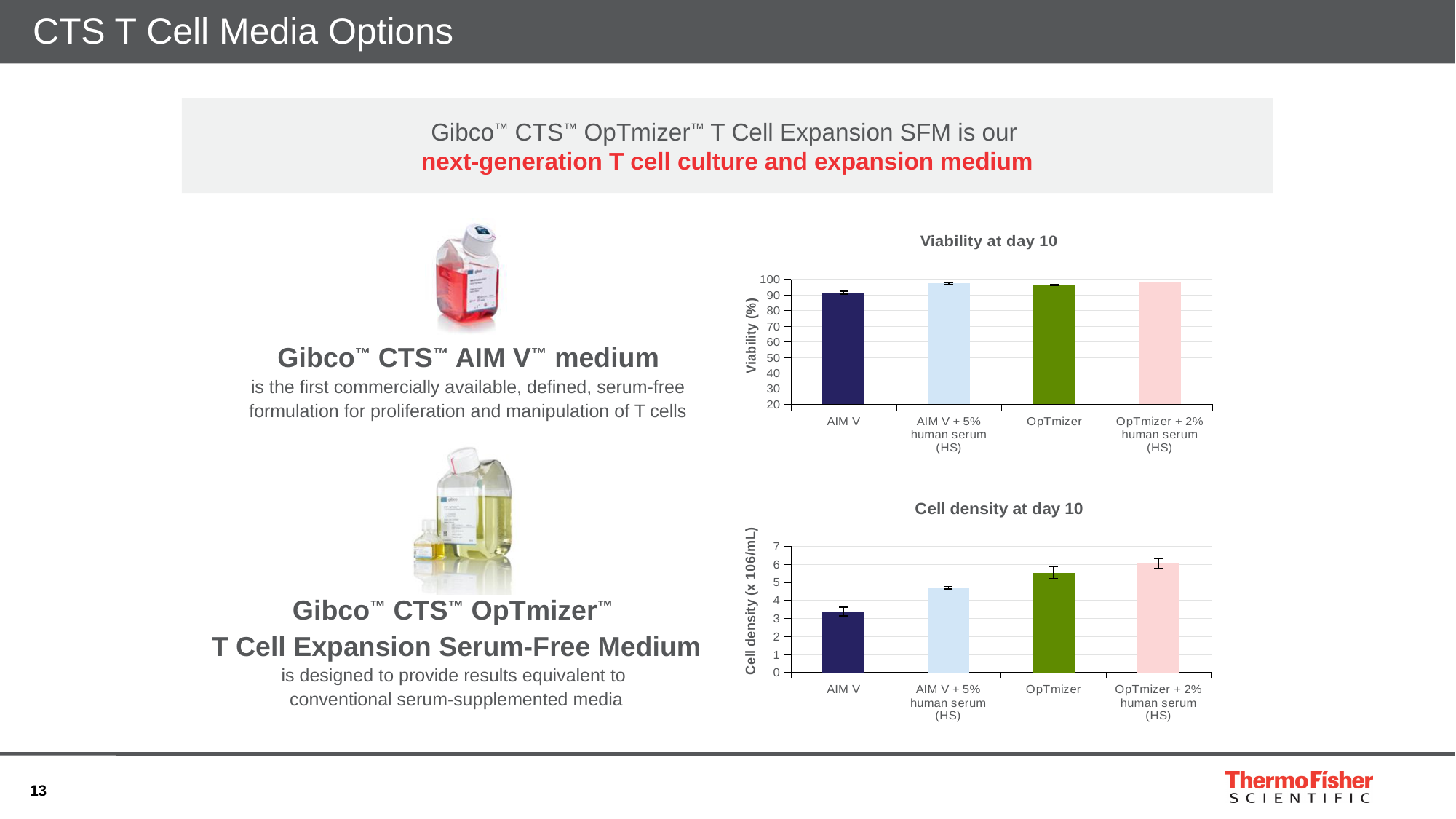
In the "Cell density at day 10" chart, which category has the highest cell density? OpTmizer + 2% human serum (HS) In the "Cell density at day 10" chart, is the value for AIM V greater or less than 4? less In the "Viability at day 10" chart, is the value for AIM V greater or less than 80? greater What is the y-axis label of the "Viability at day 10" chart? Viability (%) What kind of chart is the "Viability at day 10" chart? bar chart In the "Cell density at day 10" chart, do the values rise or fall from left to right along the x axis? rise In the "Cell density at day 10" chart, which category has the lowest cell density? AIM V In the "Cell density at day 10" chart, which is larger, the value for AIM V or the value for OpTmizer? OpTmizer In the "Cell density at day 10" chart, is the value for OpTmizer greater or less than 5? greater In the "Viability at day 10" chart, which category has the lowest viability? AIM V How many categories are shown on the x axis of the "Cell density at day 10" chart? 4